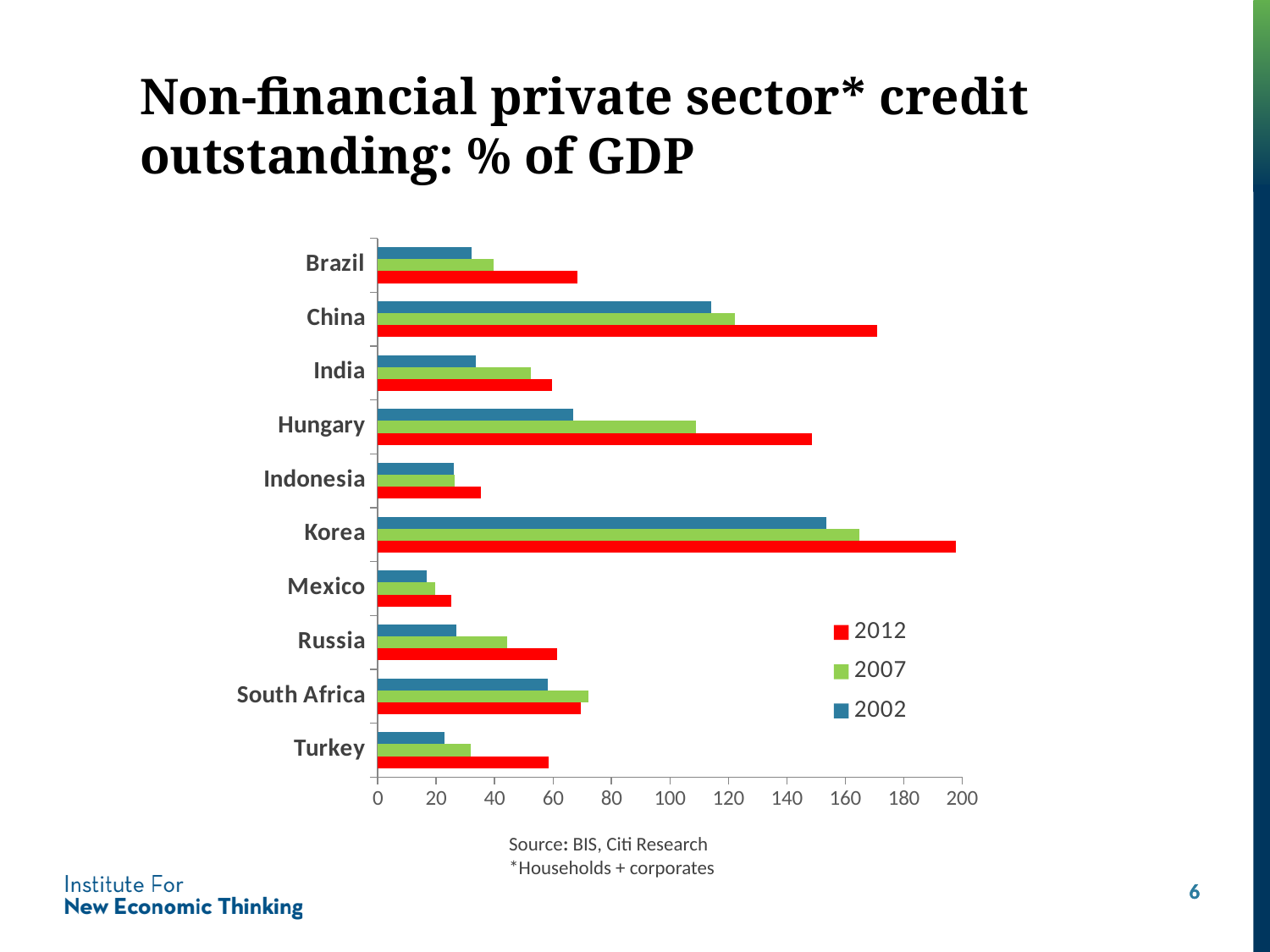
Is the 2012 value for Hungary greater or less than 140? greater How many countries are shown on the chart? 10 Which is larger, the 2012 value for Brazil or the 2012 value for India? Brazil Is the 2012 value for China greater or less than 160? greater Which country has the highest 2002 value? Korea Which country has the lowest 2012 value? Mexico Is the 2012 value for Indonesia greater or less than 40? less What kind of chart is shown on the slide? bar chart Which is larger, the 2012 value for China or the 2012 value for Hungary? China How many series does the legend list? 3 Which colour represents the 2012 series in the legend? red Which country has the highest 2012 value? Korea